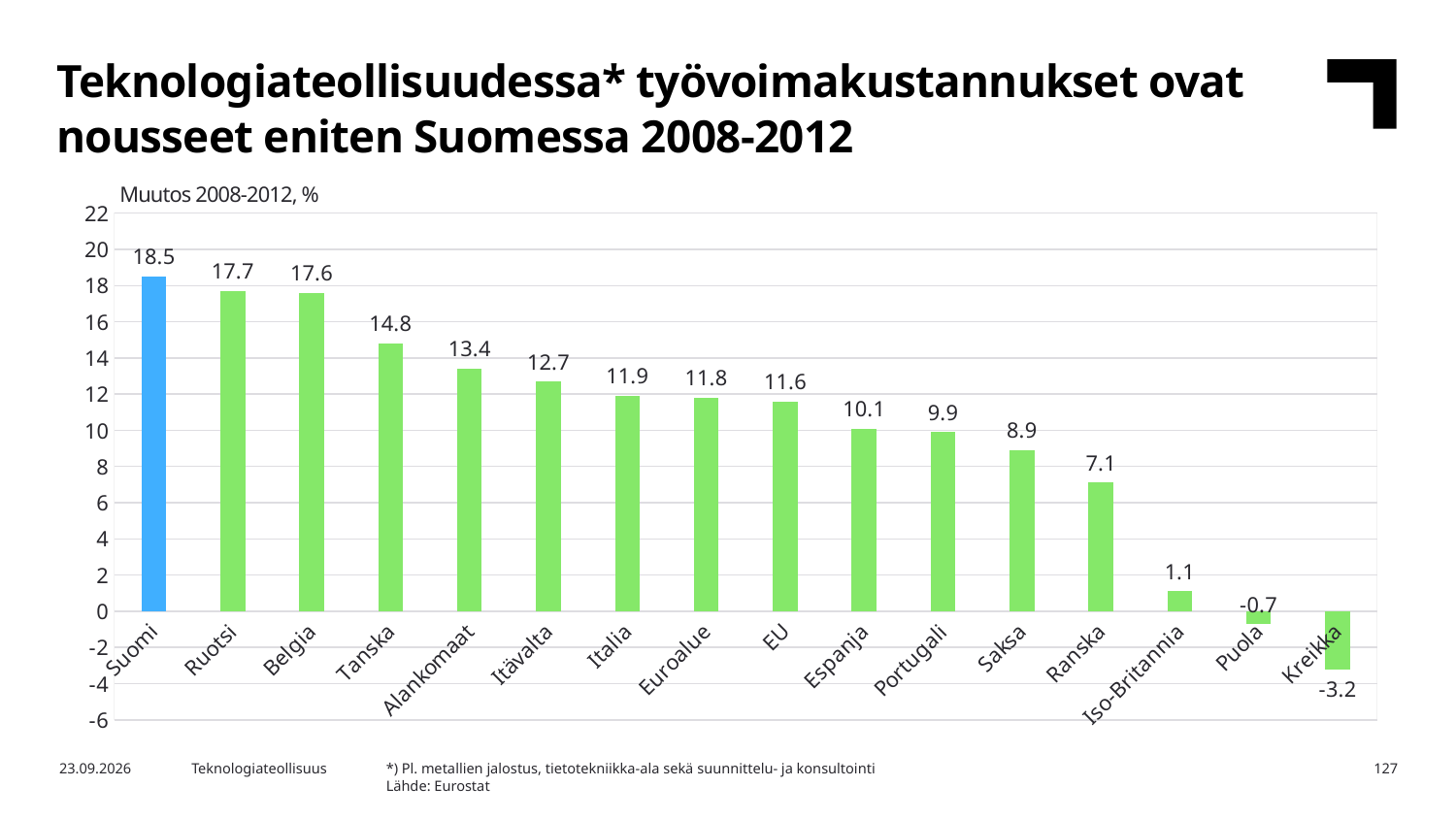
Which country has the highest value? Suomi What is the value for Suomi? 18.5 Do the values rise or fall from left to right along the x axis? fall What is the value for EU? 11.6 Which country has the lowest value? Kreikka What kind of chart is this? bar chart Which is larger, the value for Tanska or the value for Itävalta? Tanska How many countries or regions are shown on the x axis? 16 What is the value for Kreikka? -3.2 What is the difference between the values for Suomi and Ruotsi? 0.8 Which bar is coloured differently from the others? Suomi What is the value for Alankomaat? 13.4